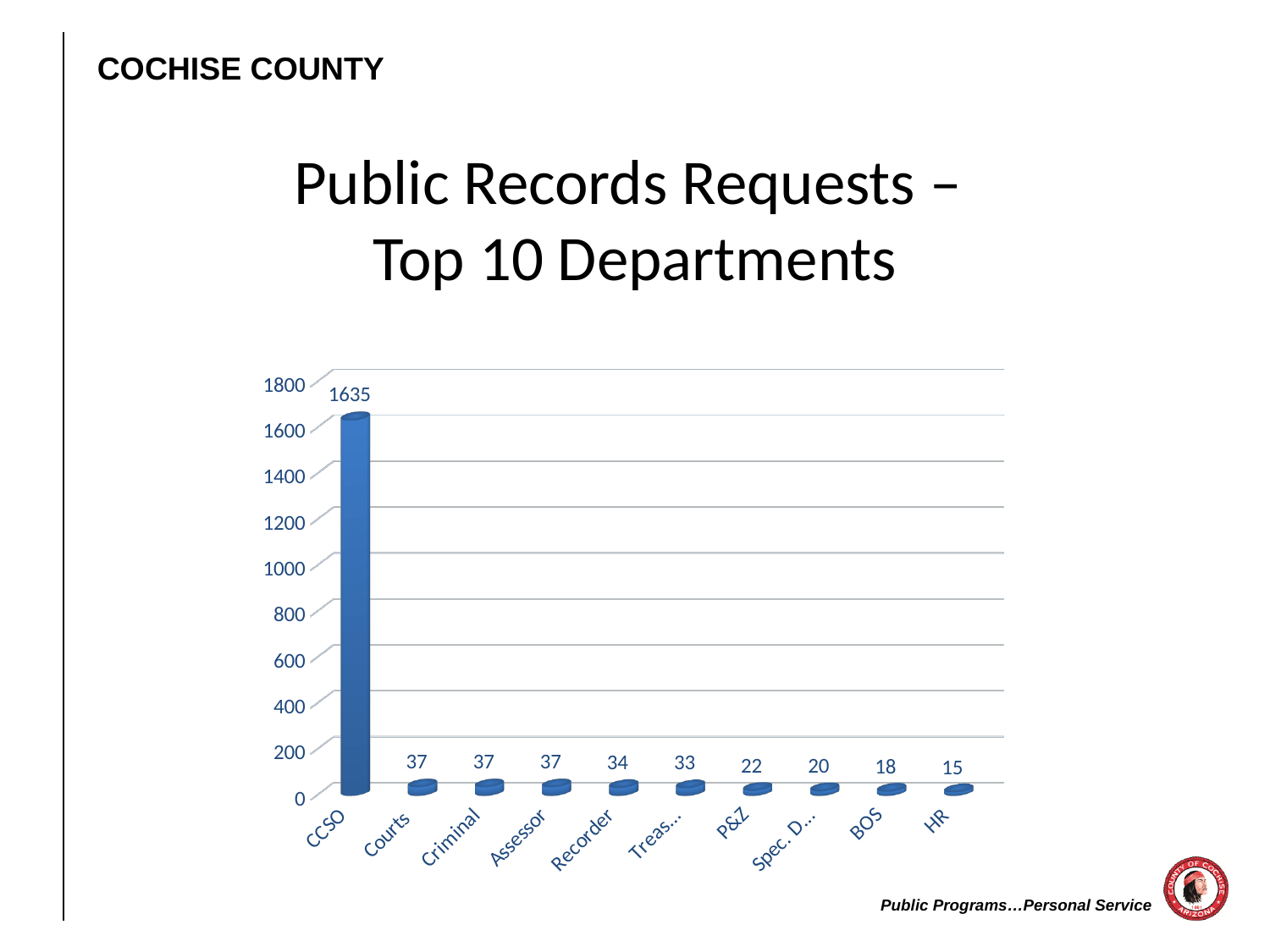
How many departments are shown on the chart? 10 What is the value for P&Z? 22 Do the values rise or fall from left to right along the x axis? fall Which is larger, the value for P&Z or the value for BOS? P&Z Which department has the lowest number of public records requests? HR What is the value for CCSO? 1635 What kind of chart is shown on the slide? bar chart What is the difference between the values for CCSO and Courts? 1598 What is the difference between the values for Recorder and HR? 19 What is the value for Recorder? 34 What is the value for BOS? 18 Which department has the highest number of public records requests? CCSO